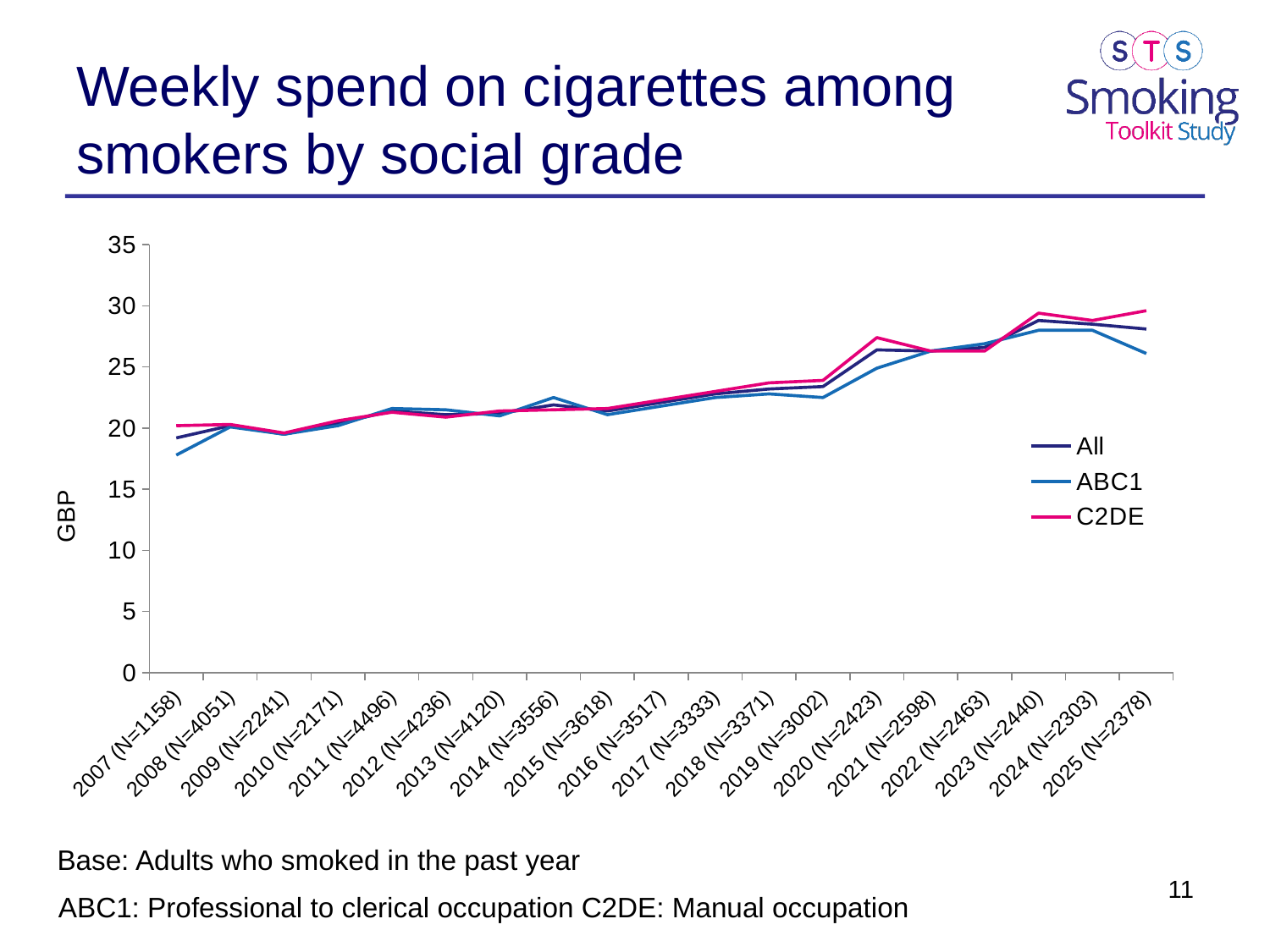
What kind of chart is shown on the slide? Line chart How many series does the legend list? 3 In 2007 (N=1158), which series has the lowest value? ABC1 Is the value for C2DE in 2025 (N=2378) greater or less than 25? greater In 2025 (N=2378), which series has the highest value? C2DE Is the value for ABC1 in 2007 (N=1158) greater or less than 20? less Is the value for ABC1 in 2019 (N=3002) greater or less than 25? less Overall, do the weekly spend values rise or fall from 2007 to 2025? Rise How many years are plotted along the x axis? 19 In 2007 (N=1158), which is larger: the value for ABC1 or the value for C2DE? C2DE What is the label on the y axis? GBP